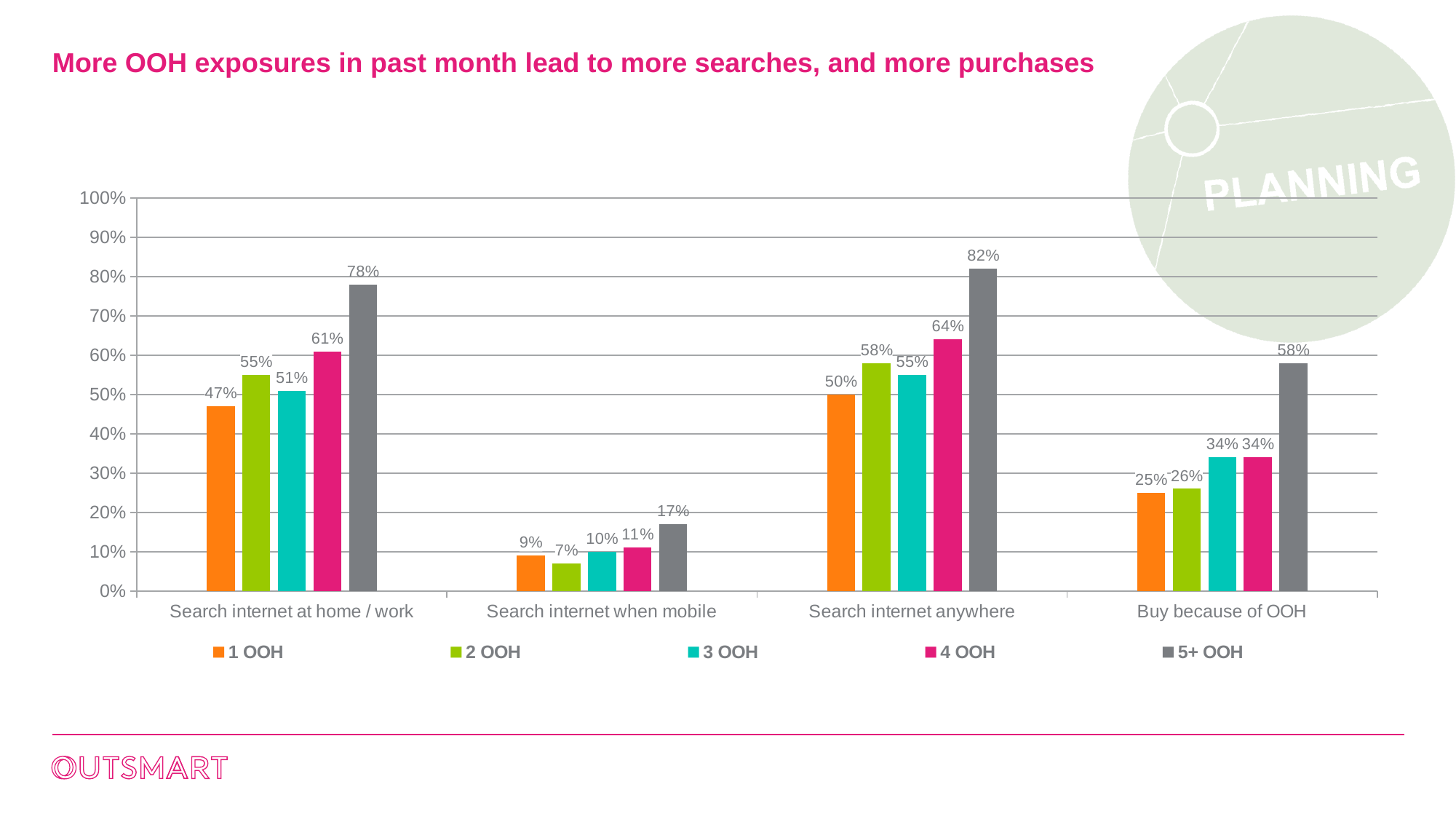
What is the difference between the 5+ OOH and 1 OOH values in the Search internet at home / work category? 31% What is the value for 1 OOH in the Search internet at home / work category? 47% What is the value for 2 OOH in the Search internet when mobile category? 7% What is the value for 3 OOH in the Buy because of OOH category? 34% Which series has the highest value in the Buy because of OOH category? 5+ OOH How many series does the legend list? 5 What is the value for 5+ OOH in the Search internet anywhere category? 82% How many categories are shown on the x axis? 4 Which series has the lowest value in the Search internet when mobile category? 2 OOH What kind of chart is shown on the slide? Bar chart What colour represents the 4 OOH series? Pink Which is larger in the Search internet anywhere category: the 2 OOH value or the 3 OOH value? 2 OOH